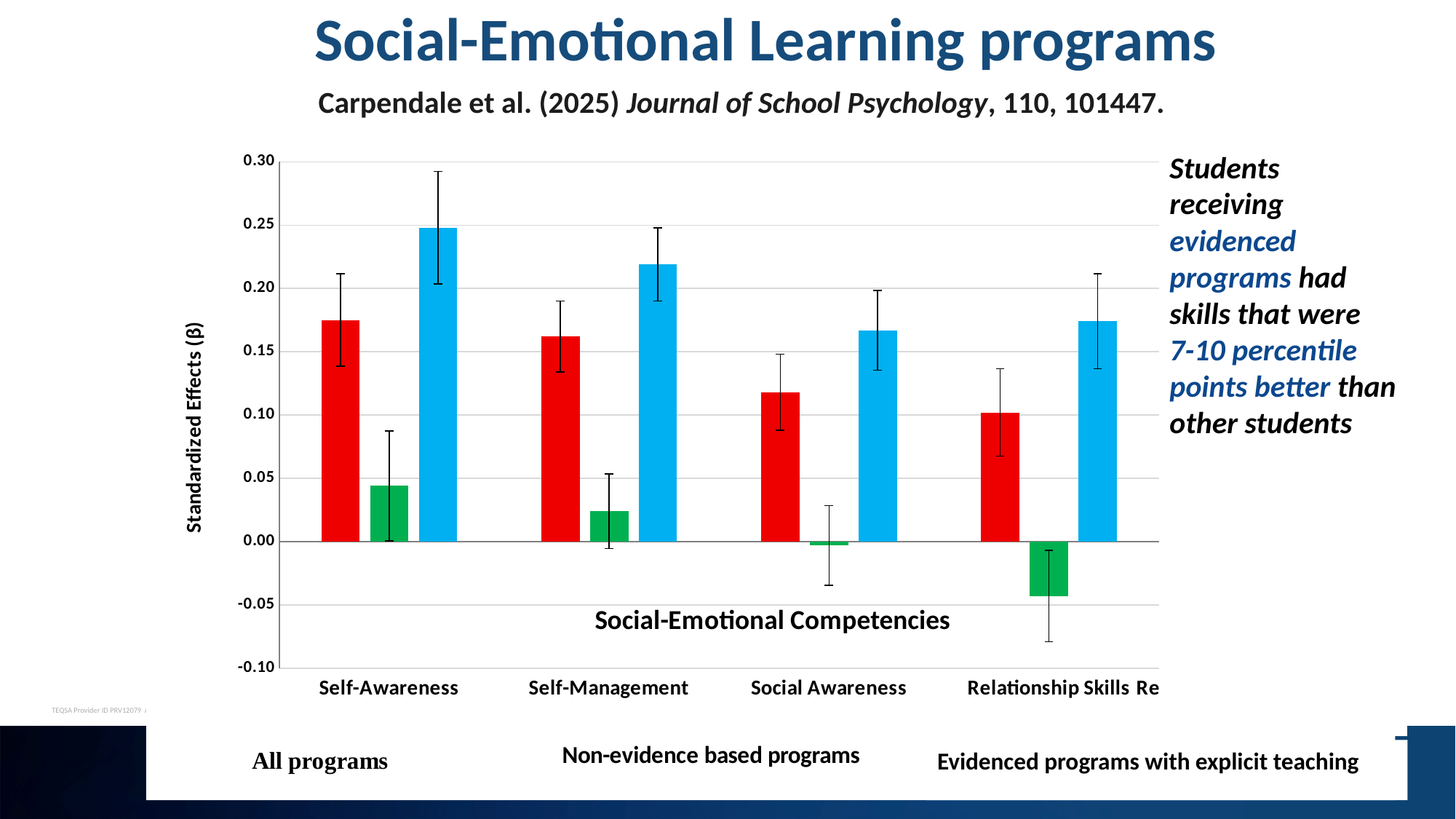
Is the value for All programs at Self-Awareness greater or less than 0.15? greater How many program series are plotted in the chart? 3 Is the value for All programs at Social Awareness greater or less than 0.10? greater For which competency is the Non-evidence based programs bar lowest? Relationship Skills For which competency is the Evidenced programs with explicit teaching bar highest? Self-Awareness Do the All programs bars rise or fall from Self-Awareness to Relationship Skills? fall At Self-Awareness, which is larger: the All programs bar or the Evidenced programs with explicit teaching bar? Evidenced programs with explicit teaching Is the value for Non-evidence based programs at Self-Management greater or less than 0.05? less What kind of chart is shown on the slide? Bar chart What is the title of the vertical axis? Standardized Effects (β)